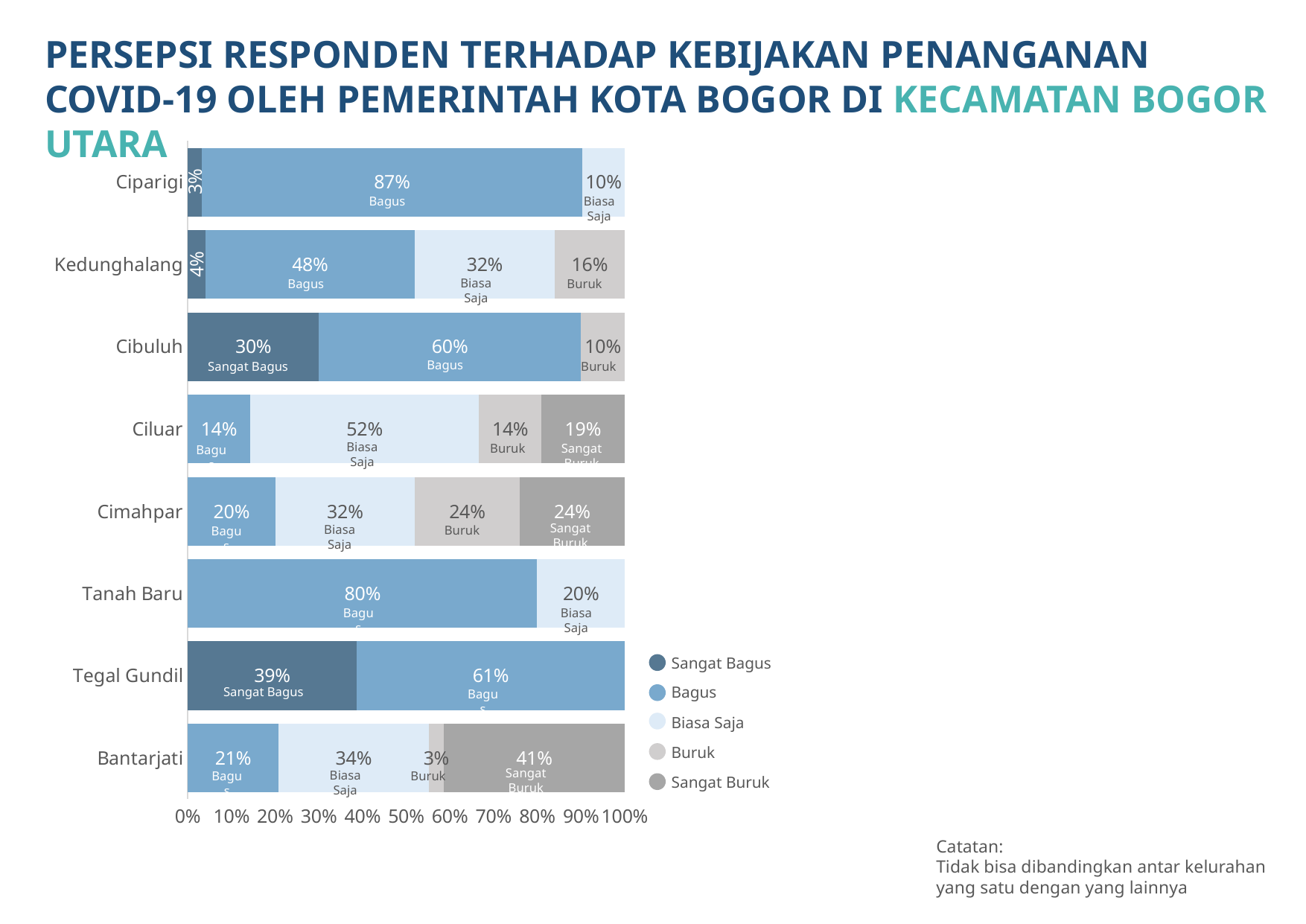
Which is larger: the Biasa Saja value for Ciluar or the Biasa Saja value for Cimahpar? Ciluar What is the Sangat Buruk share for Bantarjati? 41% How many kelurahan are shown on the chart? 8 What percentage of respondents in Ciparigi rated the policy as Bagus? 87% What is the Biasa Saja value for Kedunghalang? 32% How many series does the legend list? 5 Which kelurahan has the highest Bagus percentage? Ciparigi Which kelurahan has the highest Sangat Buruk percentage? Bantarjati What kind of chart is shown on the slide? Stacked bar chart What is the Sangat Bagus value for Tegal Gundil? 39% What is the total of the Tegal Gundil bar (Sangat Bagus plus Bagus)? 100% What is the difference between the Bagus and Sangat Bagus values for Cibuluh? 30%